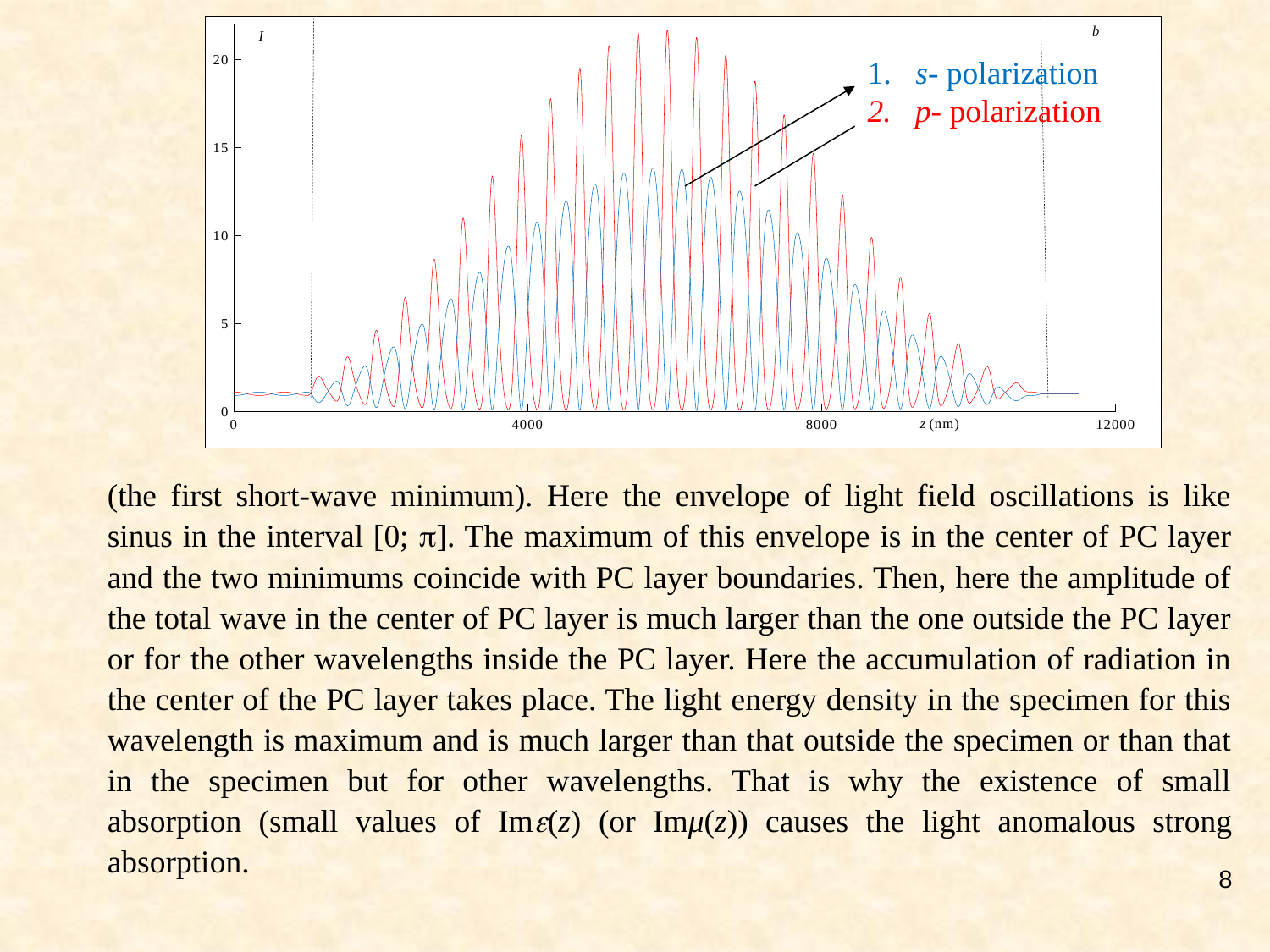
Do the peak heights of the curves rise or fall as z increases from about 6000 nm to 12000 nm? fall What kind of chart is shown on the slide? line chart Which series is plotted in blue? s- polarization Is the highest peak of the p-polarization curve greater or less than 20? greater What is the largest tick value shown on the x axis? 12000 Do the peak heights of the curves rise or fall as z increases from 0 to about 6000 nm? rise Is the value of the p-polarization curve at z = 0 greater or less than 5? less Which series is plotted in red? p- polarization Which series reaches the higher maximum intensity, s-polarization or p-polarization? p- polarization How many series does the legend list? 2 Is the highest peak of the s-polarization curve greater or less than 10? greater